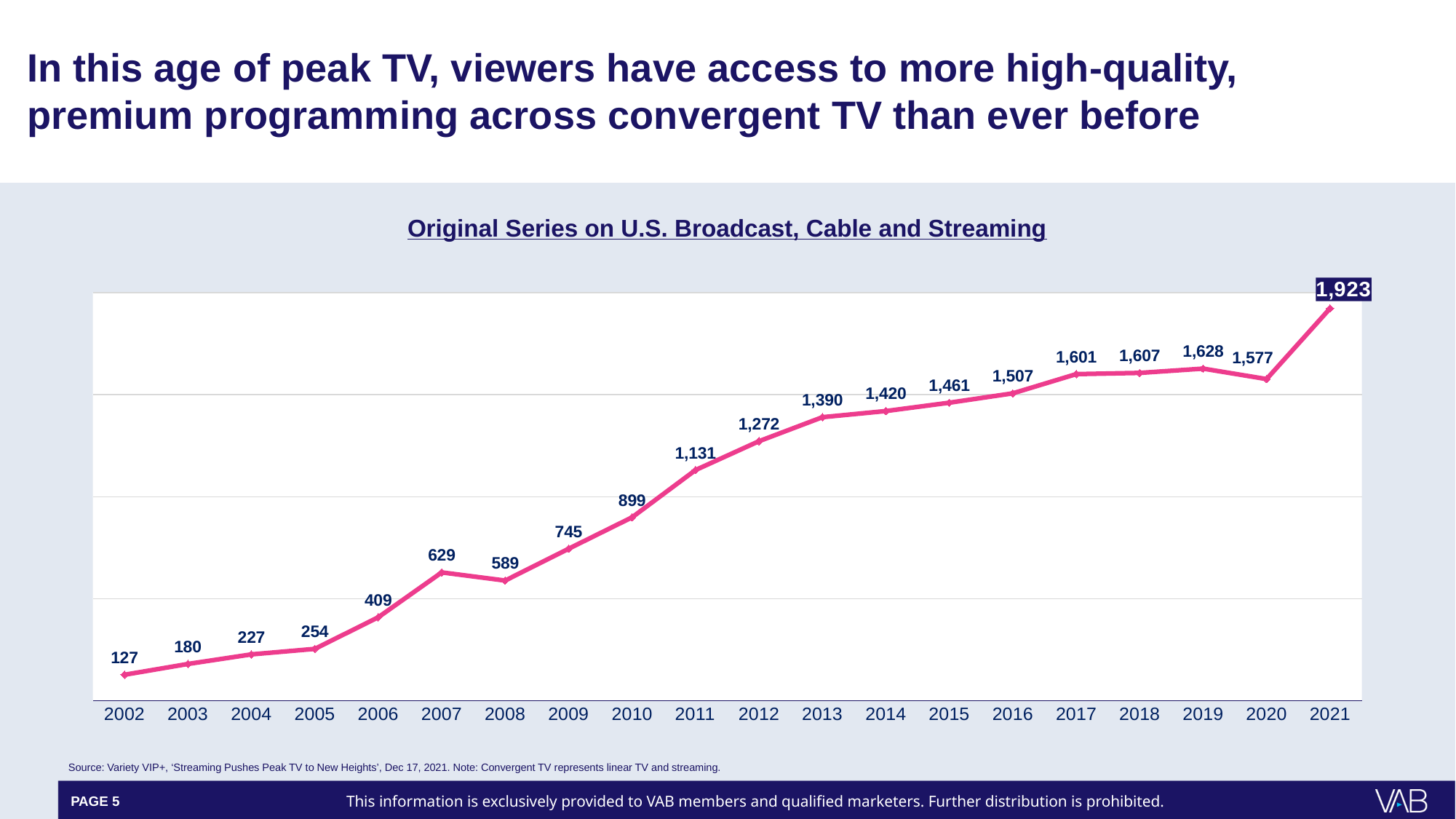
What kind of chart is this? line chart Which year has the highest value? 2021 What is the value for 2002? 127 How many years are plotted on the chart? 20 Which year has the lowest value? 2002 What is the difference between the values for 2021 and 2020? 346 What is the title of the chart? Original Series on U.S. Broadcast, Cable and Streaming What is the difference between the values for 2008 and 2007? 40 What is the value for 2021? 1,923 Do the values generally rise or fall from 2002 to 2021? rise Which is larger, the value for 2019 or the value for 2020? 2019 What is the value for 2013? 1,390